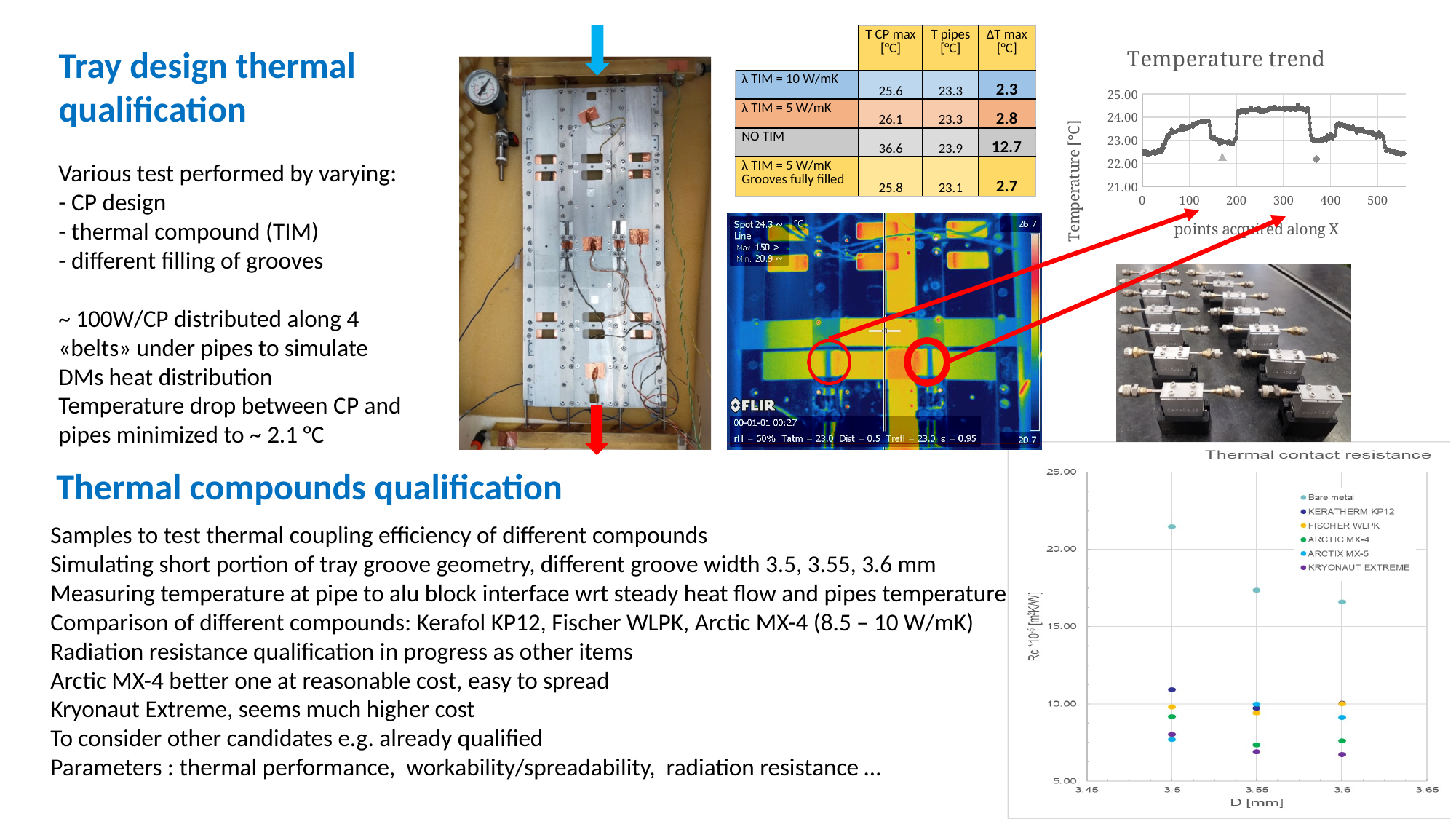
In the Thermal contact resistance chart, is the KRYONAUT EXTREME value at D = 3.6 mm greater or less than 10.00? less In the Temperature trend chart, is the temperature at 0 points greater or less than 23.00? less In the Thermal contact resistance chart, is the Bare metal value larger at D = 3.5 mm or at D = 3.6 mm? 3.5 mm What is the title of the chart in the top right of the slide? Temperature trend In the Thermal contact resistance chart, how many different groove widths (D values) have data points plotted? 3 In the Thermal contact resistance chart, which series has the highest values at every groove width? Bare metal In the Temperature trend chart, is the temperature at around 300 points greater or less than 24.00? greater In the Temperature trend chart, what is the label of the y axis? Temperature [°C] What kind of chart is the Thermal contact resistance chart? scatter chart How many series does the legend of the Thermal contact resistance chart list? 6